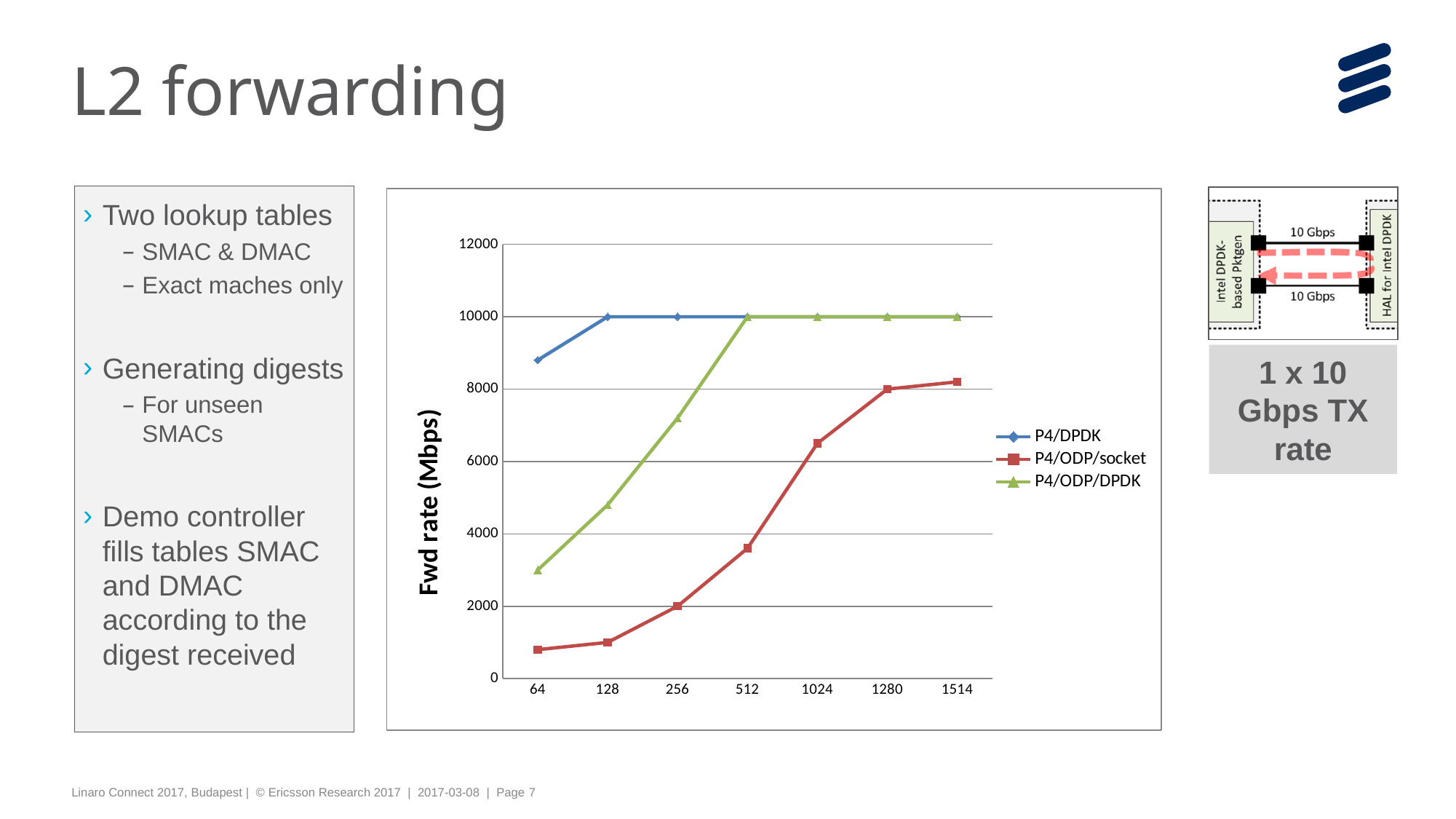
Is the value for P4/ODP/DPDK at 256 greater or less than 6000? greater What is the value for P4/ODP/socket at 256? 2000 What is the y-axis title of the chart? Fwd rate (Mbps) What is the value for P4/ODP/DPDK at 1514? 10000 Does the P4/ODP/socket series rise or fall as packet size increases along the x axis? rise Is the value for P4/DPDK at 64 greater or less than 8000? greater How many packet-size points are plotted along the x axis? 7 Is the value for P4/ODP/socket at 64 greater or less than 2000? less What kind of chart is shown on the slide? line chart Which series has the lowest value at 64? P4/ODP/socket What is the value for P4/DPDK at 512? 10000 How many series does the chart's legend list? 3